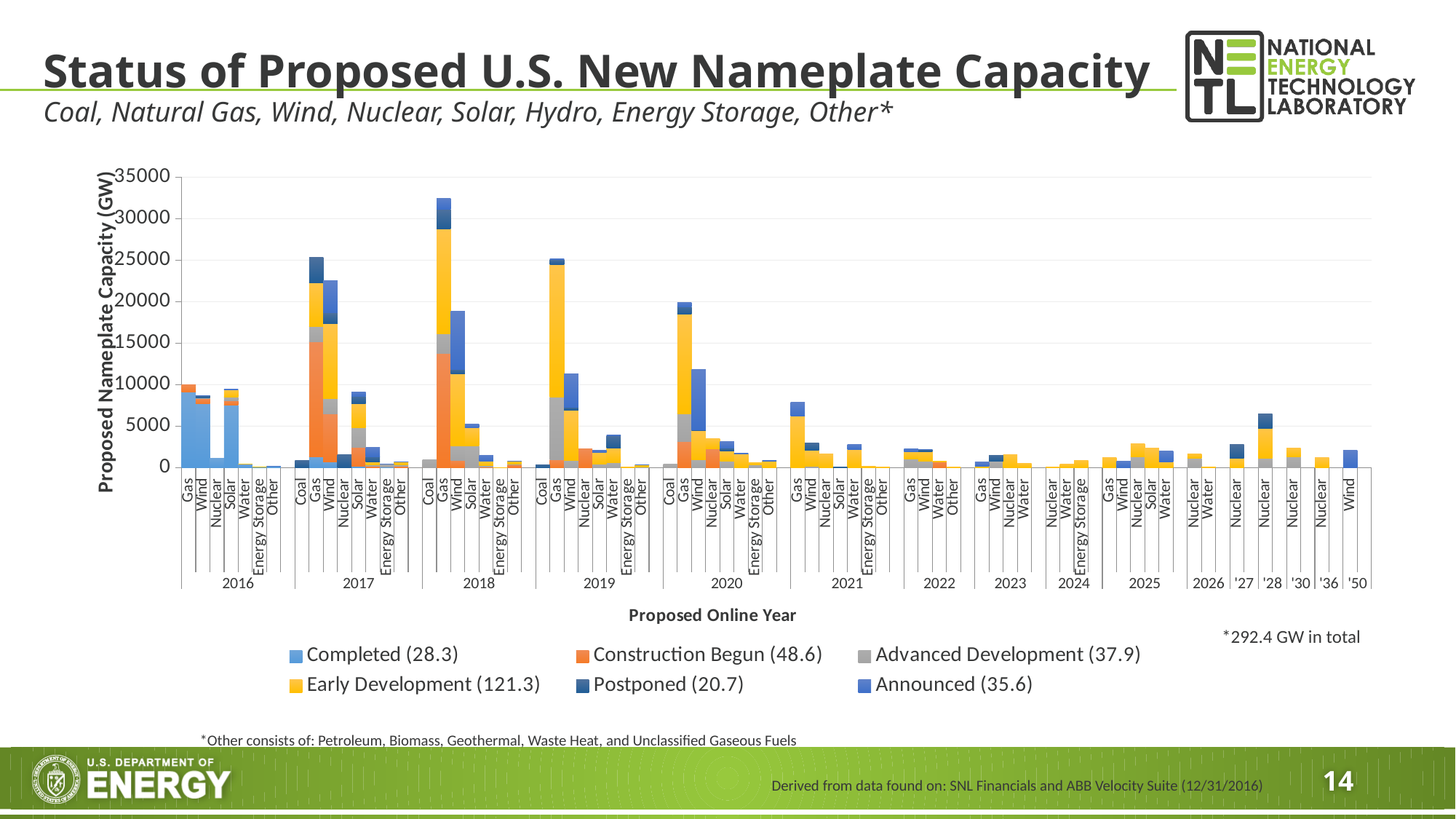
How many series does the legend list? 6 Which has the larger total stacked bar: Gas in 2019 or Gas in 2020? Gas in 2019 Which has the larger total stacked bar: Wind in 2018 or Wind in 2019? Wind in 2018 Is the total stacked value for Gas in 2017 greater or less than 20000? greater Which category and year has the tallest stacked bar? Gas, 2018 How many proposed online year groups are shown along the x axis? 16 Is the total stacked value for Gas in 2016 greater or less than 15000? less Is the total stacked value for Gas in 2018 greater or less than 30000? greater What kind of chart is shown on the slide? Stacked bar chart What total value is shown in the legend for Early Development? 121.3 What total capacity in GW is noted on the slide for all proposed capacity? 292.4 GW